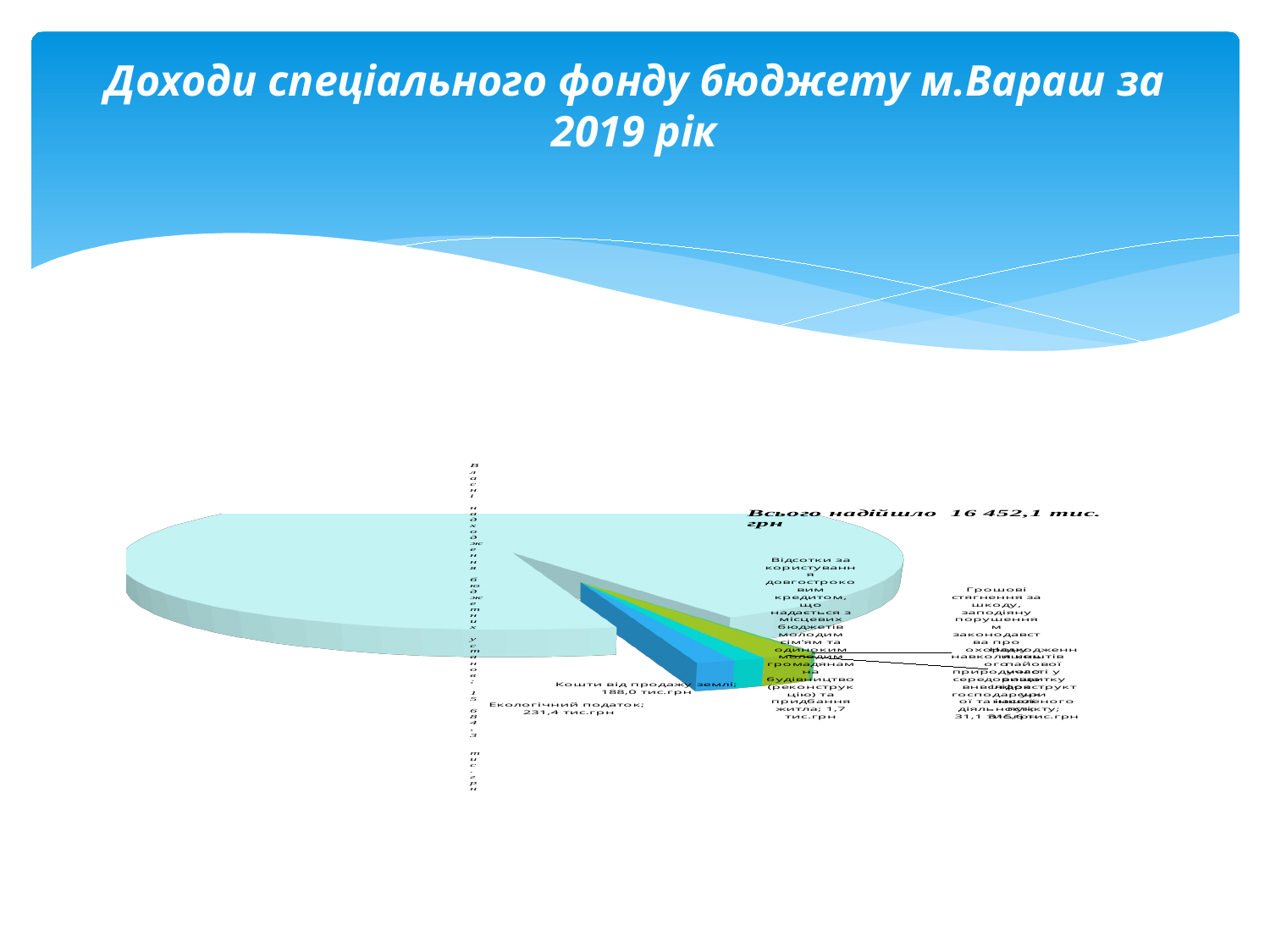
What is the difference between Екологічний податок and Кошти від продажу землі? 43,4 тис.грн What is the value for Екологічний податок? 231,4 тис.грн What is the title of the slide's chart? Доходи спеціального фонду бюджету м.Вараш за 2019 рік What total amount does the chart say was received (Всього надійшло)? 16 452,1 тис. грн What kind of chart is shown on the slide? pie chart What is the value for Грошові стягнення за шкоду, заподіяну порушенням законодавства про охорону навколишнього природного середовища? 31,1 тис.грн Which category has the smallest value shown on the chart? Відсотки за користування довгостроковим кредитом (1,7 тис.грн) Which is larger, Екологічний податок or Кошти від продажу землі? Екологічний податок What is the value for Відсотки за користування довгостроковим кредитом, що надається з місцевих бюджетів молодим сім'ям та одиноким молодим громадянам на будівництво (реконструкцію) та придбання житла? 1,7 тис.грн What is the value for Власні надходження бюджетних установ? 15 684,3 тис.грн What is the value for Кошти від продажу землі? 188,0 тис.грн Which category has the largest slice of the pie? Власні надходження бюджетних установ